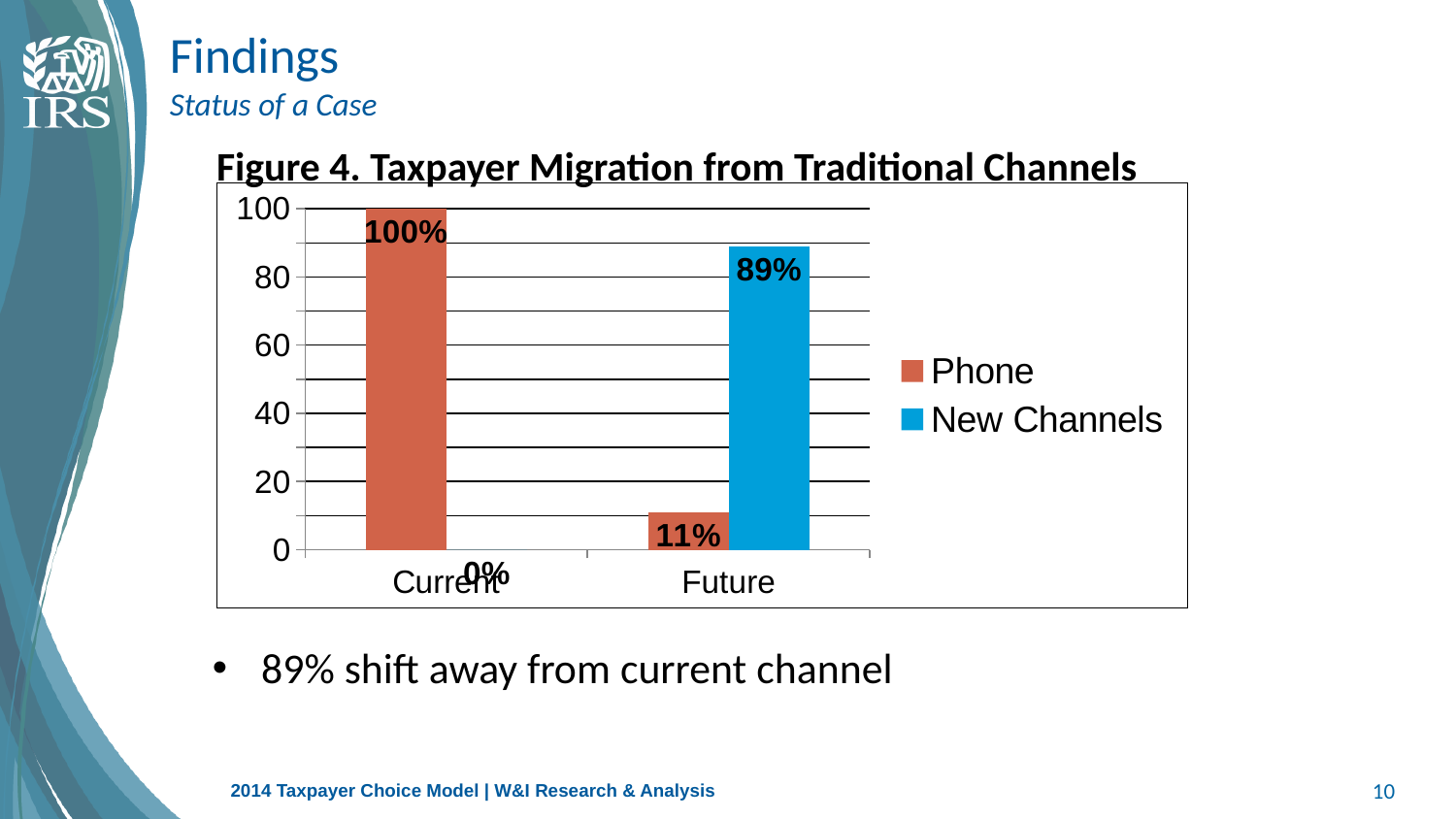
What is the value for New Channels in the Future category? 89% What is the value for Phone in the Future category? 11% Does the Phone series rise or fall from Current to Future? Fall What kind of chart is shown? Bar chart Which series has the higher value in the Future category? New Channels What is the value for Phone in the Current category? 100% What is the difference between New Channels and Phone in the Future category? 78% What is the value for New Channels in the Current category? 0% How many series does the legend list? 2 What is the title of the chart? Figure 4. Taxpayer Migration from Traditional Channels How many categories are shown on the x axis? 2 What is the difference between the Phone value for Current and the Phone value for Future? 89%